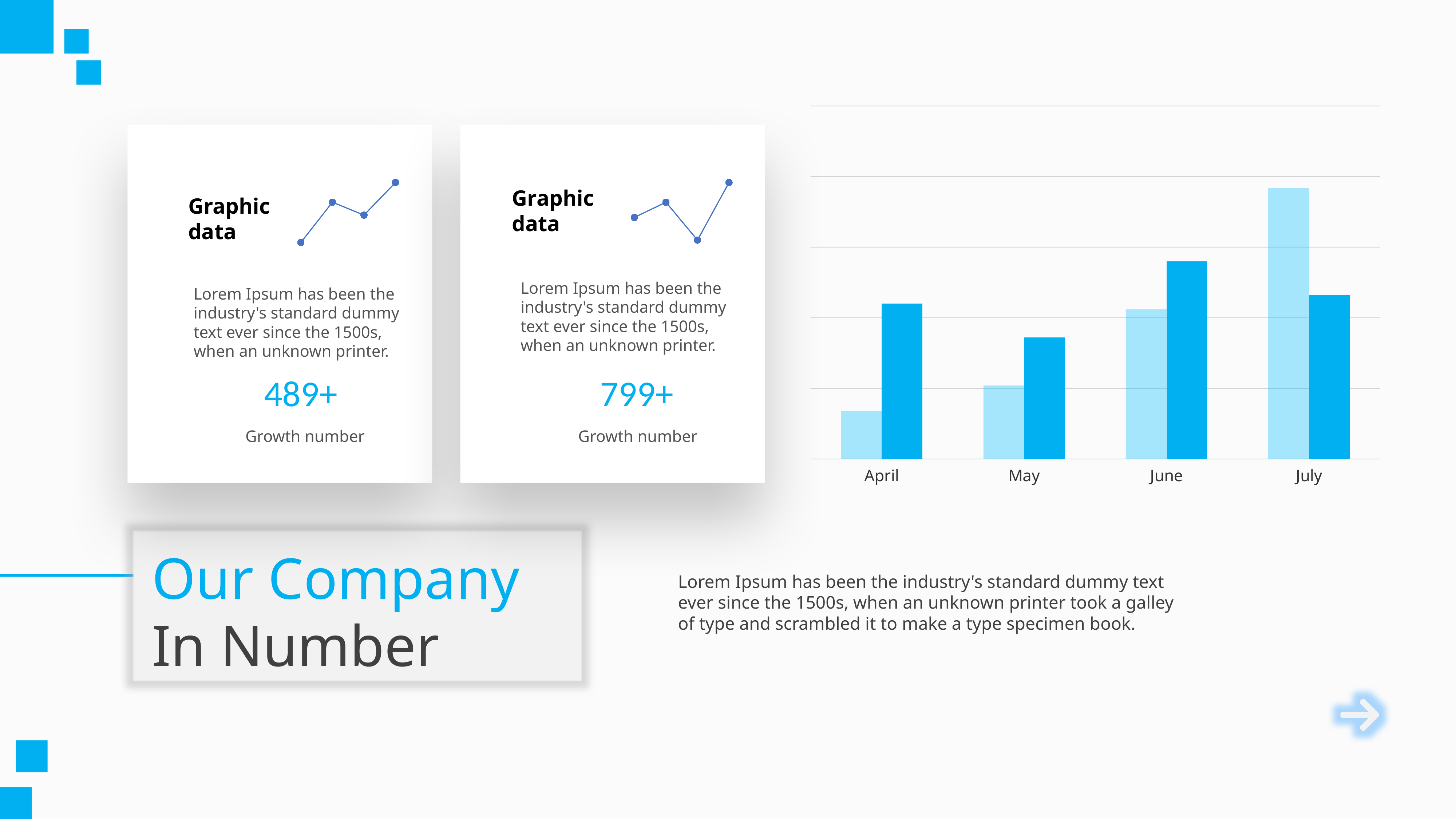
How many bars are plotted for each month in the bar chart? 2 How many months are shown on the x axis of the bar chart? 4 In the bar chart, which month has the shortest light blue bar? April In the bar chart, is the dark blue bar for June taller or shorter than the dark blue bar for May? taller What kind of chart is shown on the right side of the slide? bar chart In the bar chart, which month has the tallest dark blue bar? June In the bar chart, which month has the shortest dark blue bar? May In the bar chart, do the light blue bars rise or fall from April to July? rise In the bar chart, for April, is the light blue bar or the dark blue bar taller? dark blue What is the first month listed on the x axis of the bar chart? April In the bar chart, which month has the tallest light blue bar? July In the bar chart, for July, is the light blue bar or the dark blue bar taller? light blue